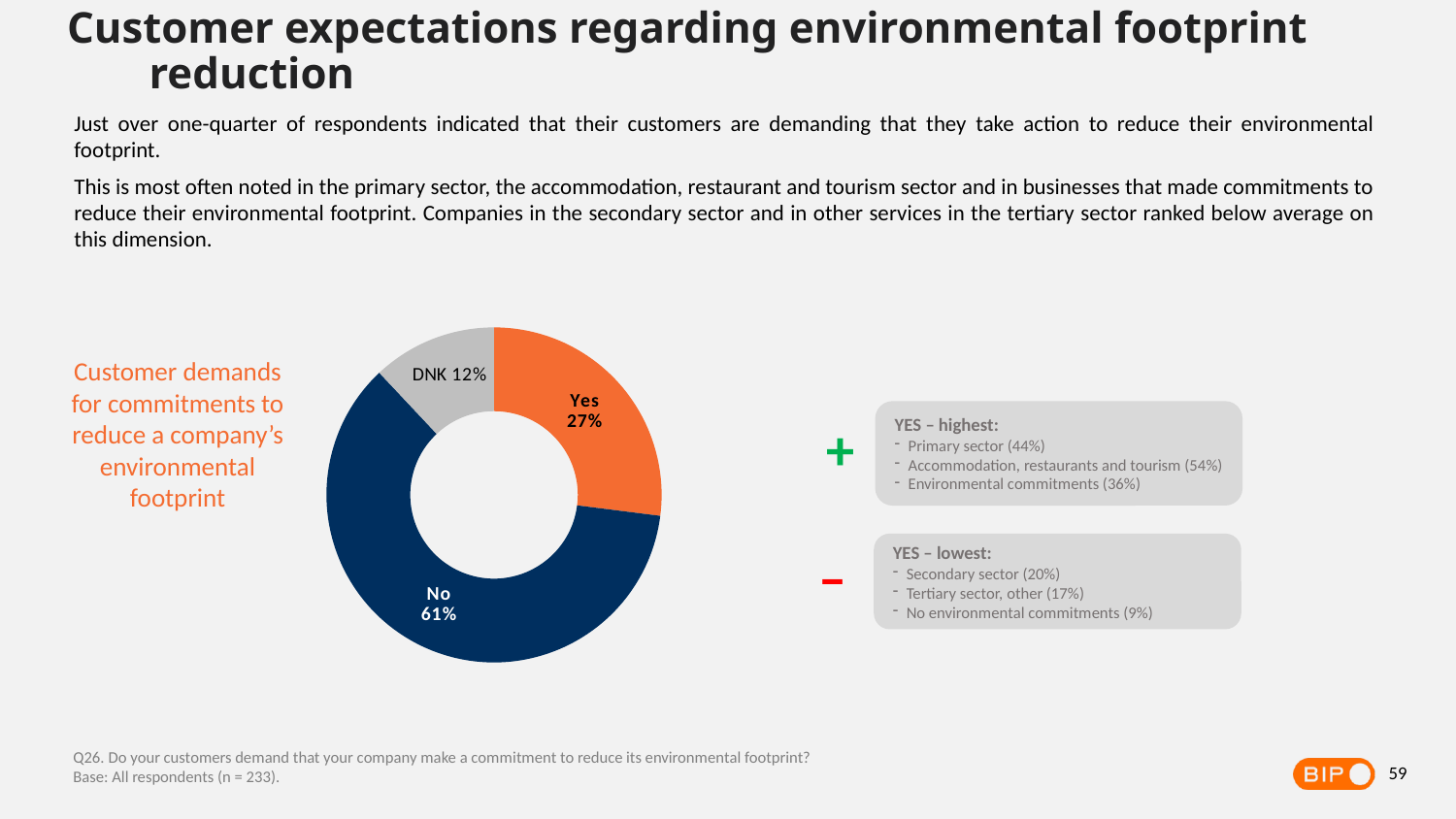
What is the combined share of Yes and No in the donut chart? 88% What percentage of respondents answered No in the donut chart? 61% Which response has the largest share in the donut chart? No What type of chart is shown on the slide? Donut chart What colour is the No segment in the donut chart? Dark blue Which is larger in the donut chart, the Yes share or the DNK share? Yes What percentage of respondents answered Yes in the donut chart? 27% What is the difference in percentage points between the No and Yes shares? 34 What percentage of respondents answered DNK in the donut chart? 12% What colour is the Yes segment in the donut chart? Orange Which response has the smallest share in the donut chart? DNK How many segments does the donut chart have? 3